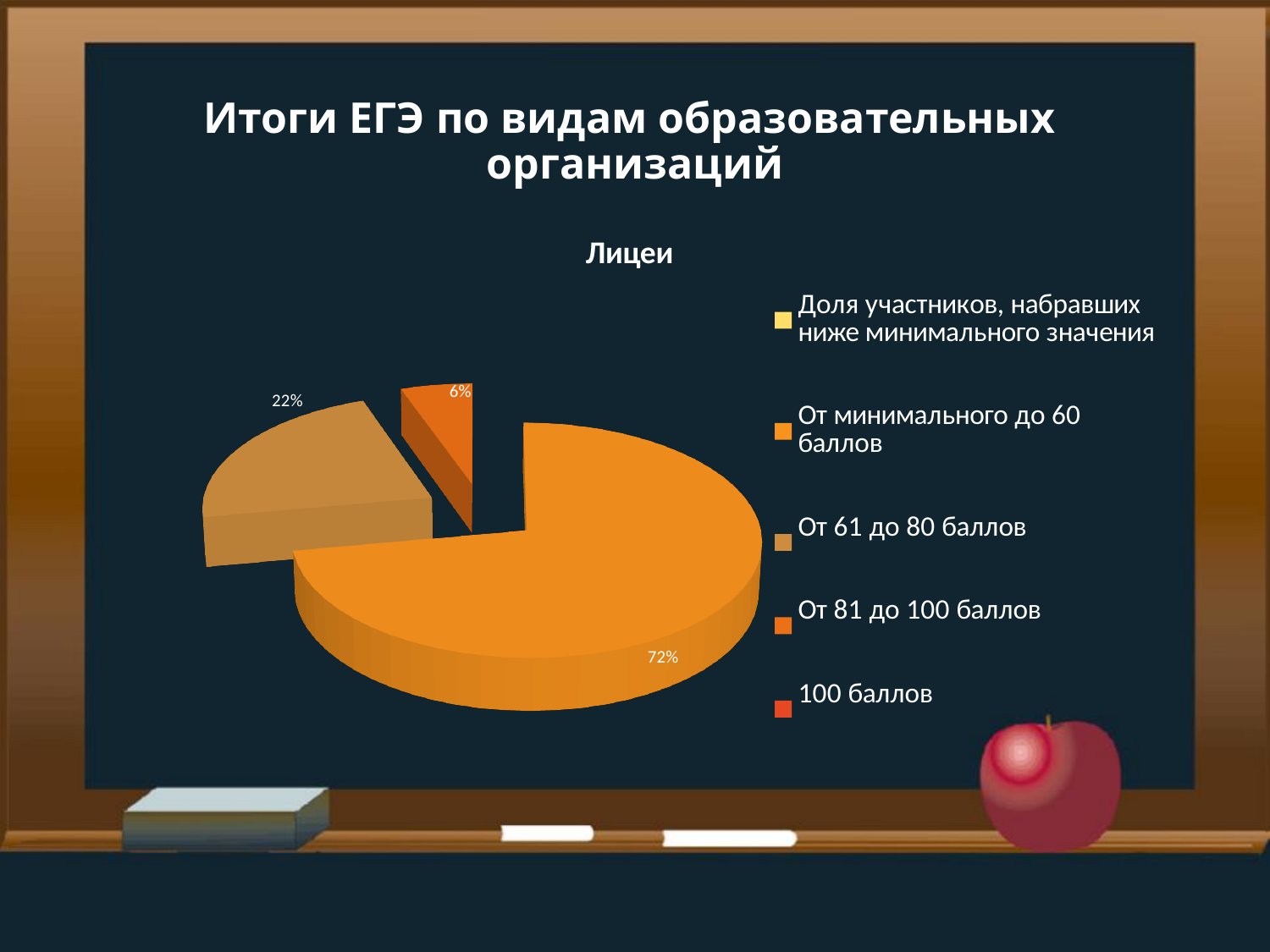
What share of the pie is labelled for the category 'От 61 до 80 баллов'? 22% What is the difference in percentage points between the 'От минимального до 60 баллов' slice and the 'От 61 до 80 баллов' slice? 50 percentage points What share of the pie is labelled for the category 'От минимального до 60 баллов'? 72% What is the combined share of the 'От 61 до 80 баллов' and 'От 81 до 100 баллов' slices? 28% What is the title of the chart? Лицеи Which category has the largest slice of the pie? От минимального до 60 баллов Which labelled slice of the pie is the smallest? От 81 до 100 баллов How many entries does the legend list? 5 Which slice is larger: 'От 61 до 80 баллов' or 'От 81 до 100 баллов'? От 61 до 80 баллов How many slices with data labels are visible in the pie chart? 3 What type of chart is shown on the slide? Pie chart What share of the pie is labelled for the category 'От 81 до 100 баллов'? 6%